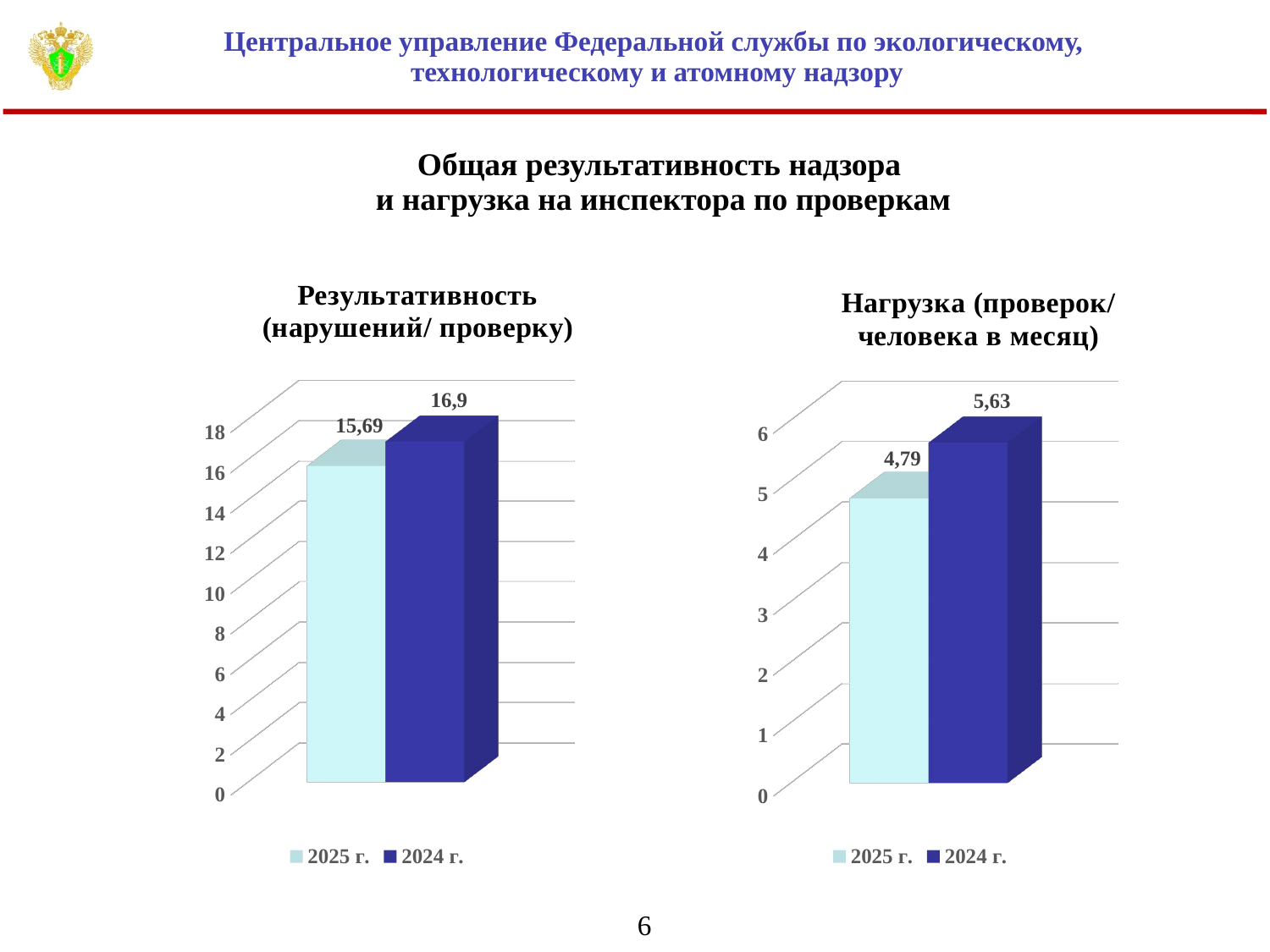
In the chart titled "Нагрузка (проверок/ человека в месяц)", what is the value for 2025 г.? 4,79 In the chart titled "Результативность (нарушений/ проверку)", what is the value for 2025 г.? 15,69 In the chart titled "Результативность (нарушений/ проверку)", what is the value for 2024 г.? 16,9 In the chart titled "Результативность (нарушений/ проверку)", what is the difference between the 2024 г. and 2025 г. values? 1,21 In the chart titled "Результативность (нарушений/ проверку)", which colour represents 2024 г. in the legend? dark blue What kind of chart is the chart titled "Нагрузка (проверок/ человека в месяц)"? bar chart In the chart titled "Нагрузка (проверок/ человека в месяц)", is the value for 2025 г. greater or less than 5? less In the chart titled "Нагрузка (проверок/ человека в месяц)", which series has the lower value? 2025 г. In the chart titled "Результативность (нарушений/ проверку)", how many series does the legend list? 2 In the chart titled "Нагрузка (проверок/ человека в месяц)", what is the value for 2024 г.? 5,63 In the chart titled "Результативность (нарушений/ проверку)", which series has the higher value? 2024 г. In the chart titled "Нагрузка (проверок/ человека в месяц)", what is the difference between the 2024 г. and 2025 г. values? 0,84